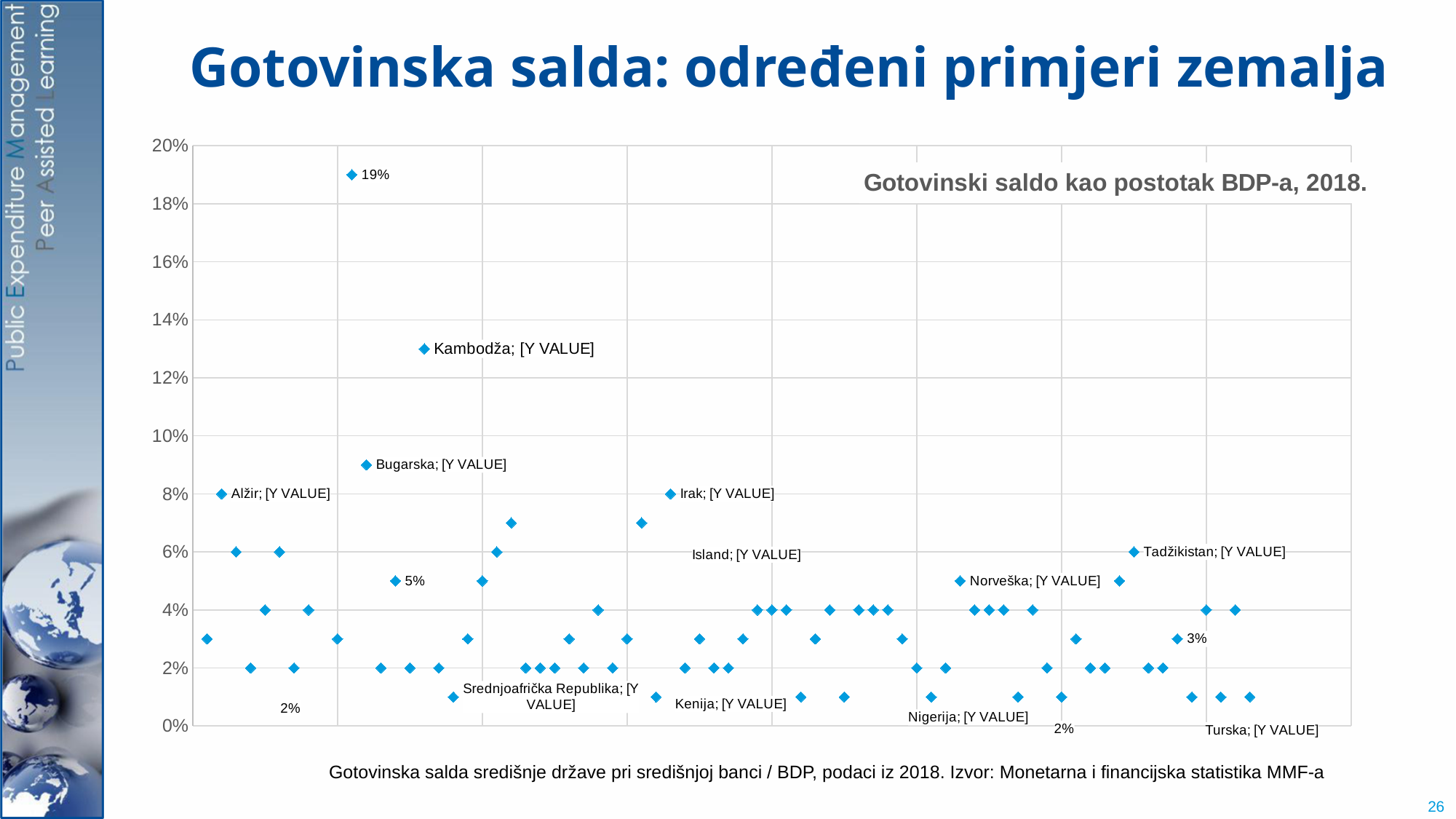
What is the value for Tadžikistan? 6% What is the title printed inside the chart area? Gotovinski saldo kao postotak BDP-a, 2018. What is the value for Alžir? 8% Which has the larger value, Alžir or Turska? Alžir Is the value for Norveška greater or less than 4%? greater Is the value for Bugarska greater or less than 8%? greater Which has the larger value, Kambodža or Bugarska? Kambodža What is the highest value plotted on the chart? 19% What kind of chart is shown on the slide? scatter chart Is the value for Kambodža greater or less than 12%? greater What is the value for Irak? 8%